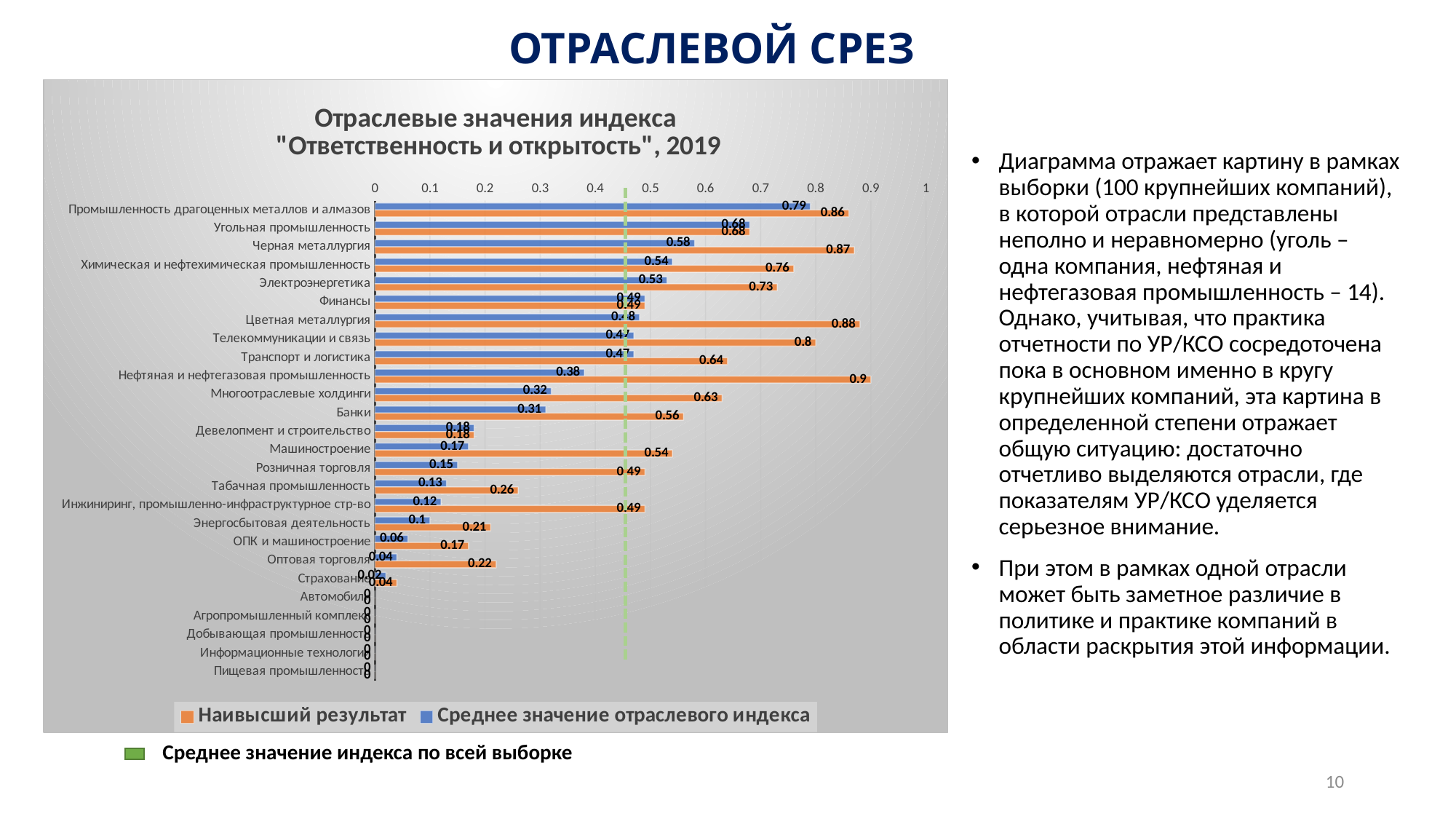
What is the "Наивысший результат" value for "Нефтяная и нефтегазовая промышленность"? 0.9 What is the "Наивысший результат" value for "Банки"? 0.56 What is the difference between the "Наивысший результат" and the "Среднее значение отраслевого индекса" for "Нефтяная и нефтегазовая промышленность"? 0.52 Which has the larger "Наивысший результат" value: "Телекоммуникации и связь" or "Транспорт и логистика"? Телекоммуникации и связь How many industry categories are plotted on the chart? 26 What is the difference between the "Наивысший результат" and the "Среднее значение отраслевого индекса" for "Черная металлургия"? 0.29 What is the title of the chart? Отраслевые значения индекса "Ответственность и открытость", 2019 Which industry has the highest "Среднее значение отраслевого индекса" value? Промышленность драгоценных металлов и алмазов What is the "Среднее значение отраслевого индекса" value for "Черная металлургия"? 0.58 Which industry has the highest "Наивысший результат" value? Нефтяная и нефтегазовая промышленность What kind of chart is shown on the slide? bar chart How many series does the chart legend list? 2